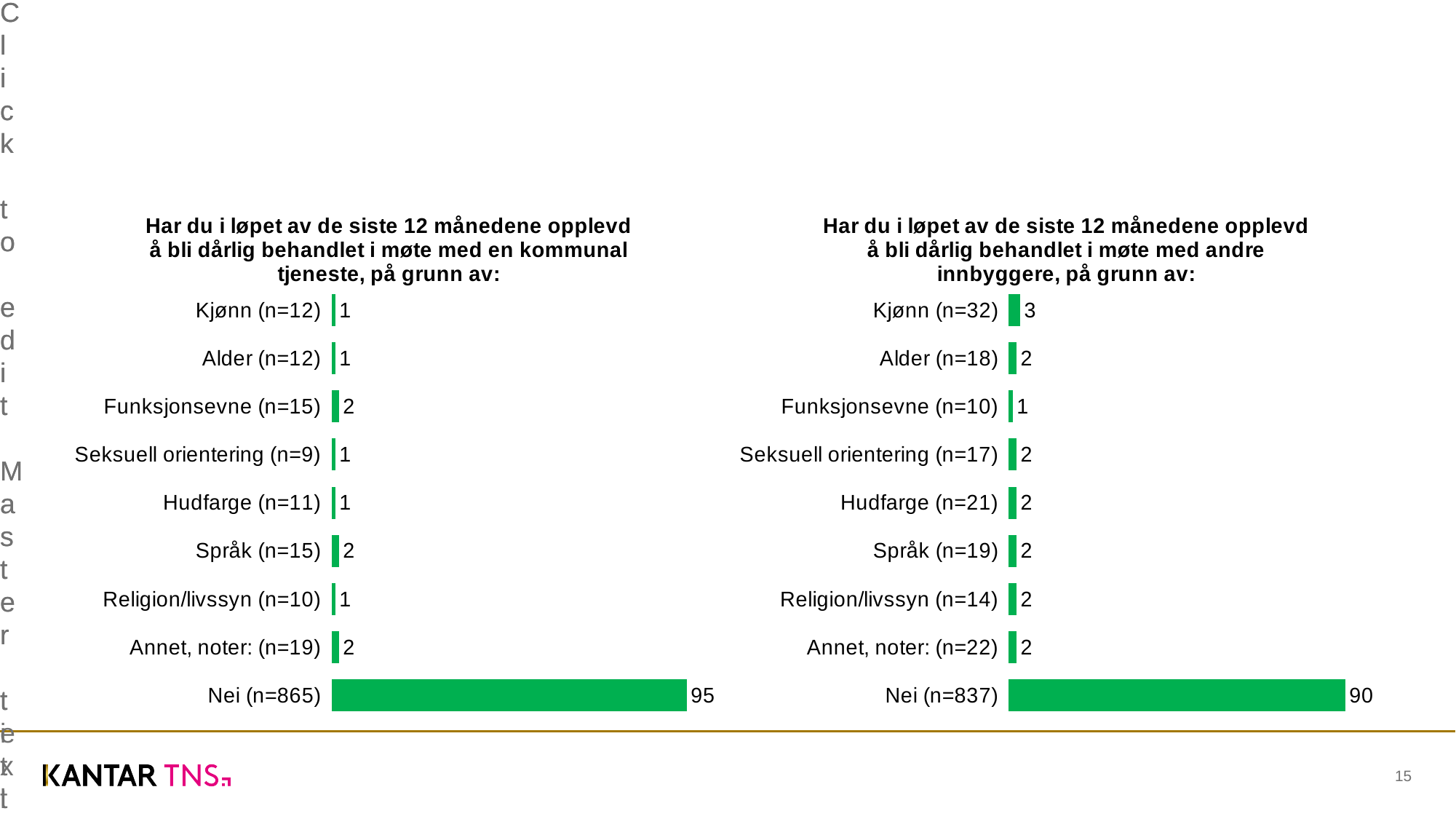
In the right chart (andre innbyggere), what is the value for Funksjonsevne (n=10)? 1 What colour are the bars in both charts? Green In the right chart (andre innbyggere), what is the value for Kjønn (n=32)? 3 How many categories are shown in the left chart (kommunal tjeneste)? 9 In the left chart (kommunal tjeneste), what is the value for Nei (n=865)? 95 In the right chart (andre innbyggere), which category has the highest value? Nei (n=837) What type of chart is the right chart (andre innbyggere)? Bar chart What is the difference between the Nei value in the left chart (95) and the Nei value in the right chart (90)? 5 In the left chart (kommunal tjeneste), what is the value for Funksjonsevne (n=15)? 2 In the left chart (kommunal tjeneste), which category has the highest value? Nei (n=865) In the right chart (andre innbyggere), what is the difference between Kjønn (n=32) and Funksjonsevne (n=10)? 2 Which is larger: the value for Kjønn in the left chart or the value for Kjønn in the right chart? Kjønn in the right chart